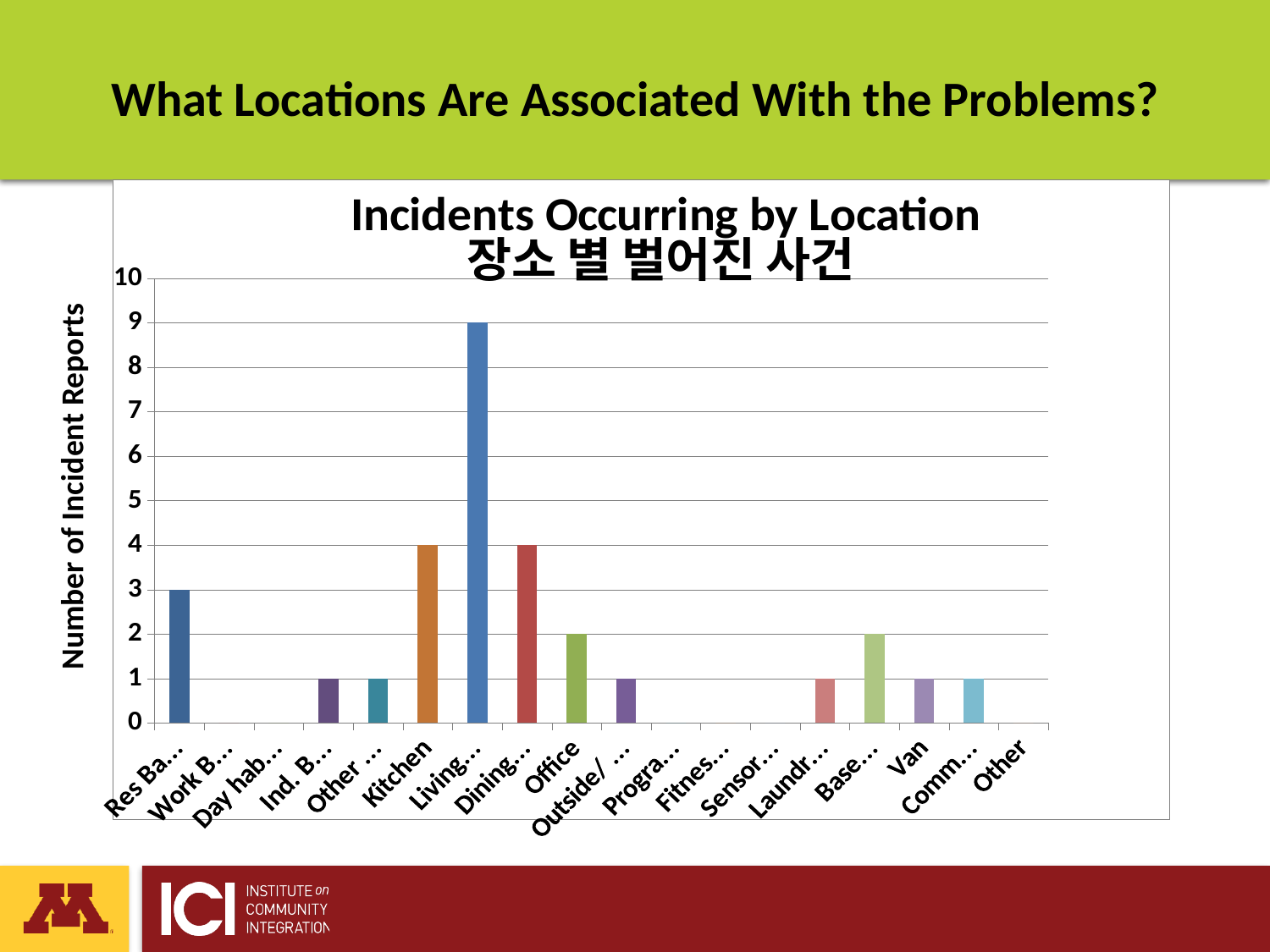
What is the number of incident reports for the rightmost category, Other? 0 Which has more incident reports, Office or Van? Office Is the value for Kitchen greater or less than 5? less How many location categories are shown on the x axis? 18 What is the difference between the number of incident reports for Kitchen and for Office? 2 What is the number of incident reports for Kitchen? 4 What is the value of the tallest bar in the chart? 9 What is the number of incident reports for Van? 1 What kind of chart is shown on the slide? bar chart What is the label of the vertical axis? Number of Incident Reports What is the number of incident reports for Office? 2 Which has more incident reports, Kitchen or Van? Kitchen